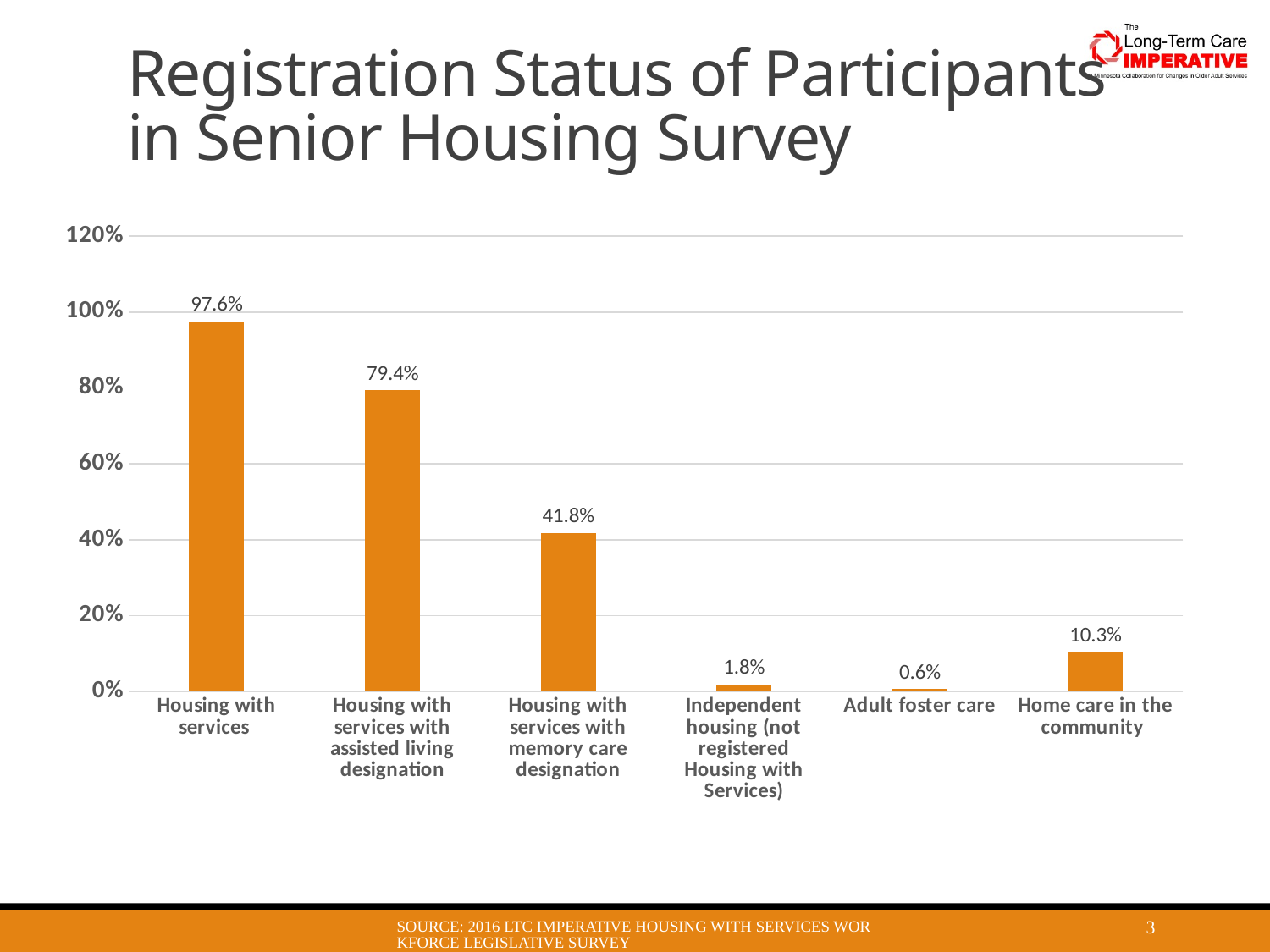
What is the value for Housing with services with memory care designation? 41.8% What is the value for Housing with services? 97.6% How many categories are shown on the x axis? 6 What is the difference between Home care in the community and Independent housing (not registered Housing with Services)? 8.5% What is the difference between Housing with services and Housing with services with assisted living designation? 18.2% What is the value for Home care in the community? 10.3% What kind of chart is shown on the slide? bar chart Which category has the lowest value? Adult foster care Which category has the highest value? Housing with services Is the value for Housing with services with memory care designation greater or less than 40%? greater Which is larger, Home care in the community or Adult foster care? Home care in the community What is the value for Housing with services with assisted living designation? 79.4%